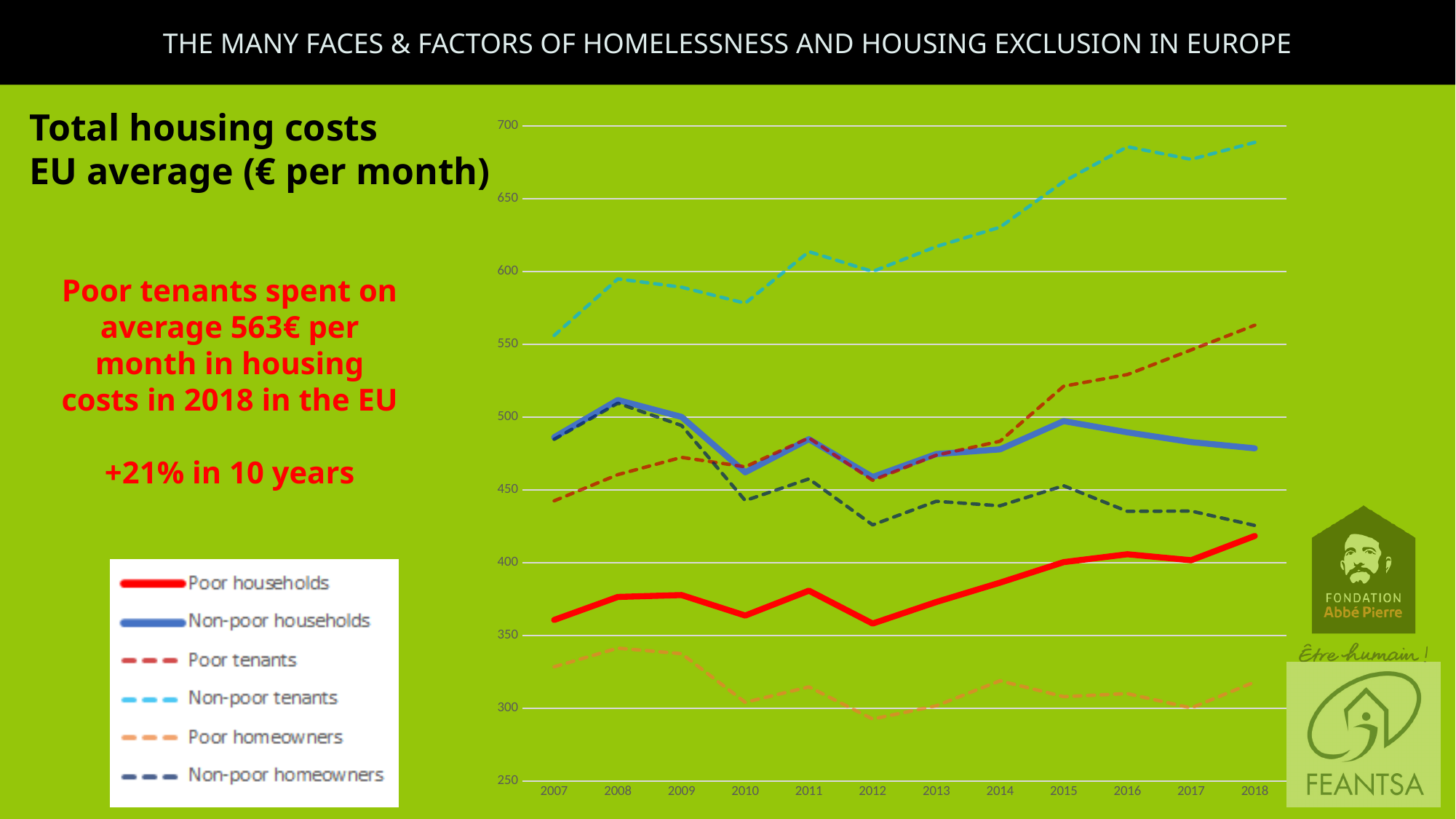
Which series has the lowest value in 2018? Poor homeowners What is the title of the chart? Total housing costs EU average (€ per month) Do the values for Non-poor tenants generally rise or fall from 2007 to 2018? rise How many years are plotted along the x axis? 12 Is the value for Non-poor homeowners in 2018 greater or less than 450? less How many series does the legend list? 6 Is the value for Non-poor tenants in 2018 greater or less than 650? greater In 2018, which is larger: Poor tenants or Non-poor households? Poor tenants According to the slide, how much did poor tenants spend on average per month on housing costs in 2018? 563€ What kind of chart is shown on the slide? Line chart Is the value for Poor households in 2012 greater or less than 400? less Which series has the highest value in 2018? Non-poor tenants